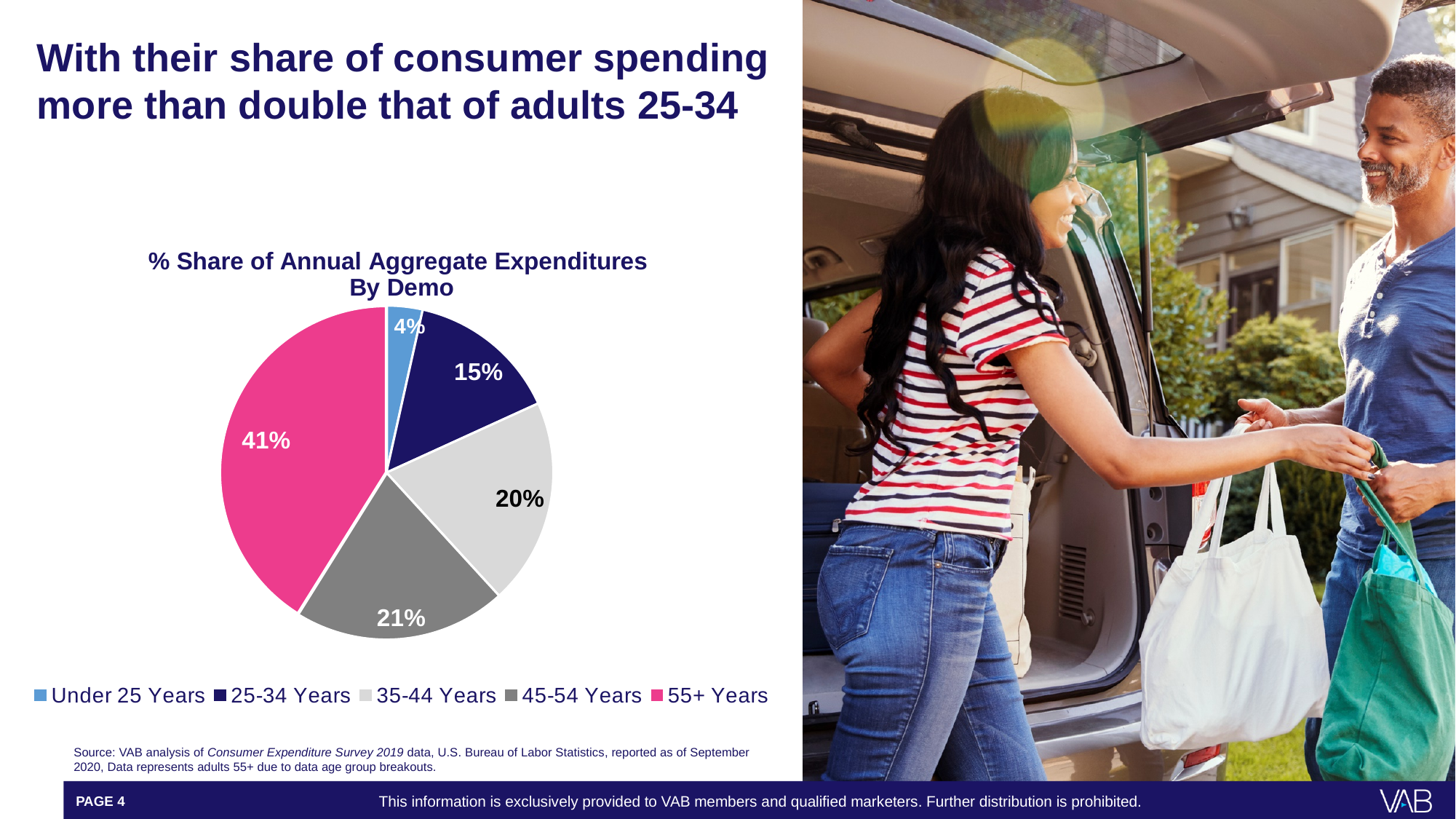
How many age groups are shown in the pie chart? 5 Which age group has the largest share of annual aggregate expenditures? 55+ Years What is the difference in share between 55+ Years and 25-34 Years? 26 percentage points What type of chart is shown on the slide? Pie chart Which age group has the smallest share of annual aggregate expenditures? Under 25 Years Which has a larger share, 45-54 Years or 35-44 Years? 45-54 Years What is the title of the chart? % Share of Annual Aggregate Expenditures By Demo What share of annual aggregate expenditures is attributed to Under 25 Years? 4% What colour represents the 55+ Years slice? Pink What share of annual aggregate expenditures is attributed to 55+ Years? 41% What share of annual aggregate expenditures is attributed to 35-44 Years? 20% What share of annual aggregate expenditures is attributed to 25-34 Years? 15%